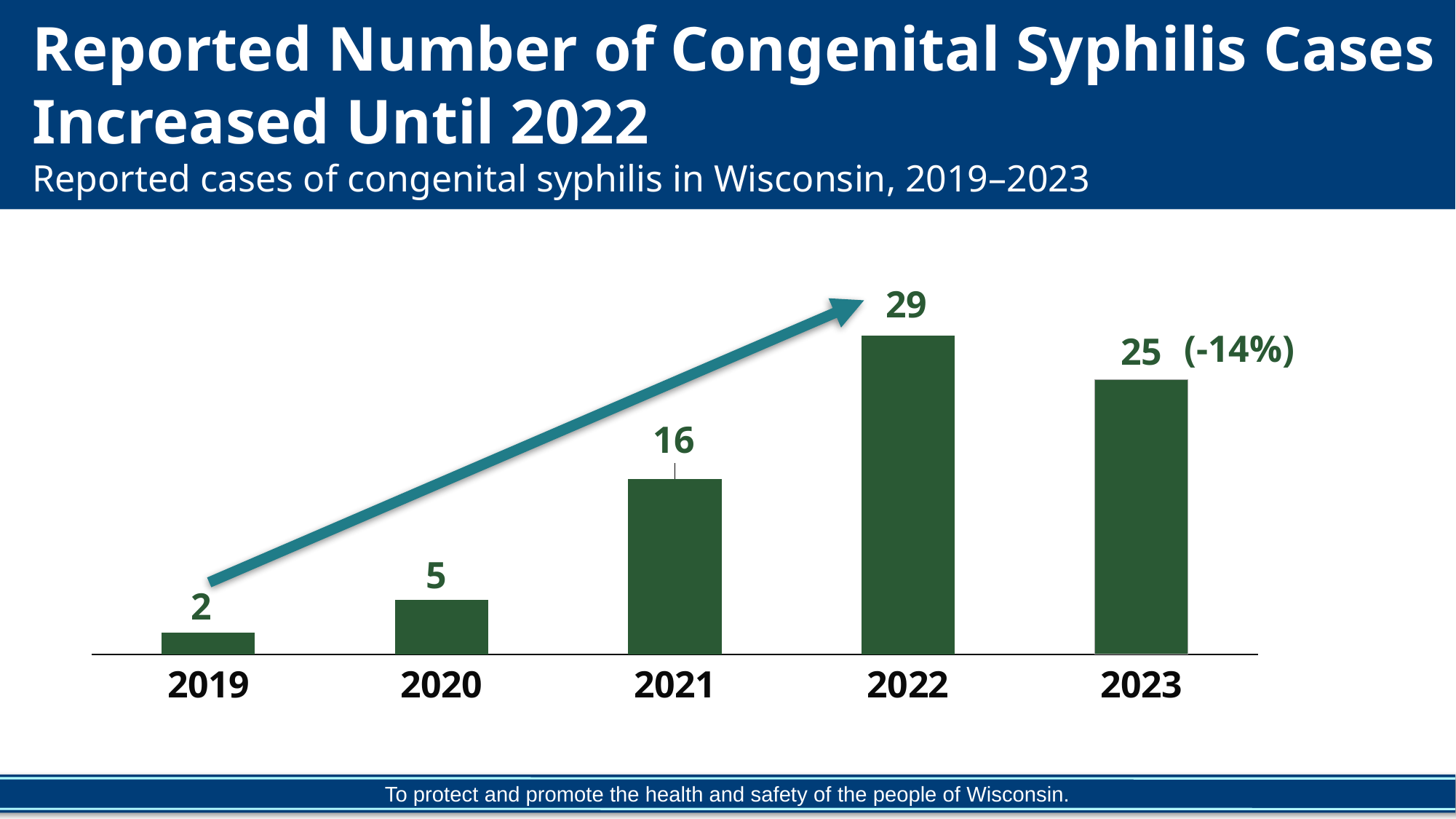
Which year has the highest number of reported cases? 2022 What kind of chart is shown on the slide? Bar chart Which year had more reported cases, 2021 or 2023? 2023 What is the value shown for 2019? 2 How many congenital syphilis cases were reported in Wisconsin in 2022? 29 How many years are shown on the x axis of the chart? 5 What is the difference between the number of cases in 2022 and 2023? 4 By how much did reported cases increase from 2020 to 2021? 11 What percentage change is annotated next to the 2023 bar? (-14%) How many cases were reported in 2021? 16 Do the reported cases rise or fall from 2019 to 2022? Rise Which year has the lowest number of reported cases? 2019